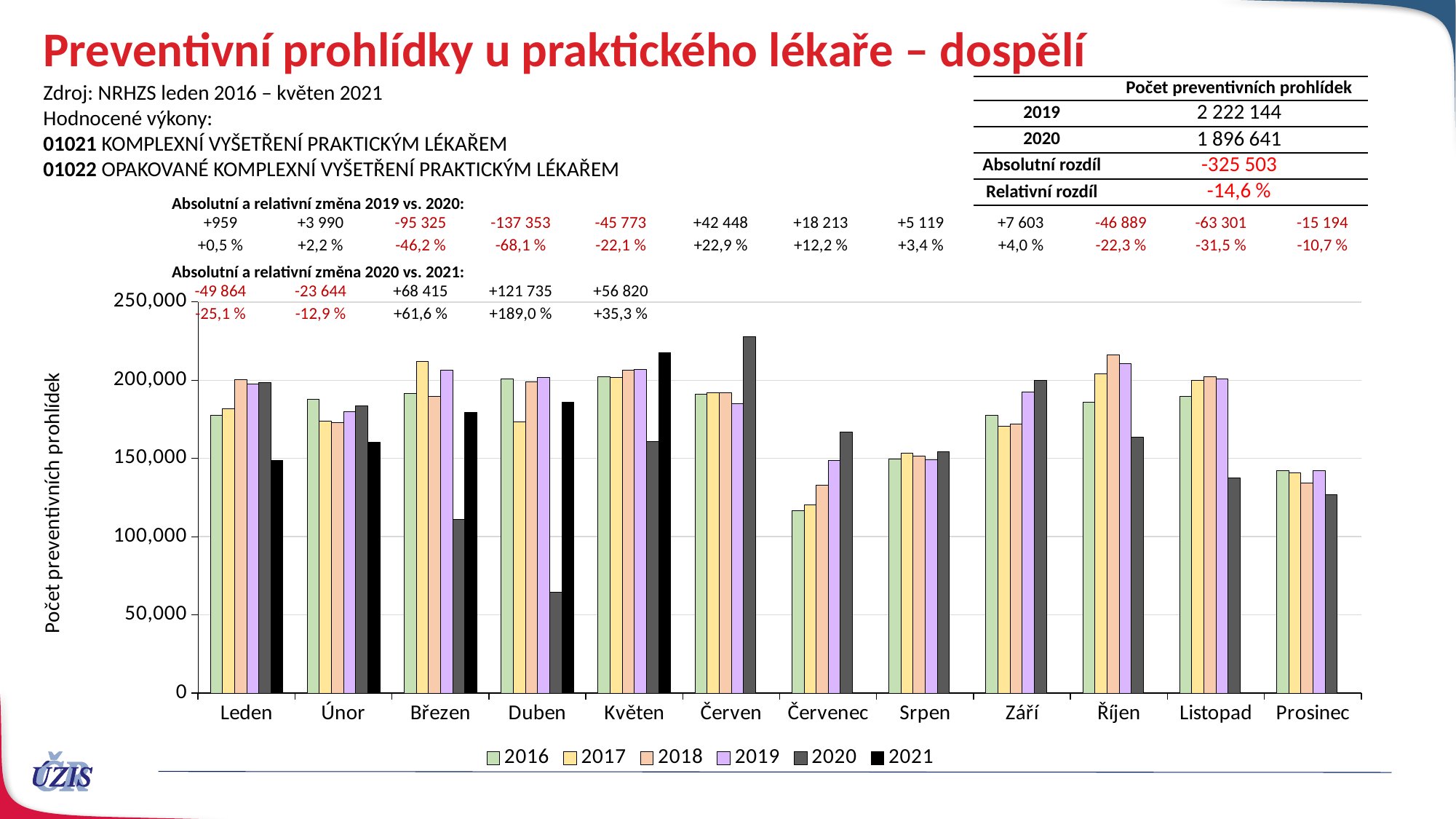
How many months (categories) are shown on the x axis of the chart? 12 In Březen, which is larger: the value for 2019 or the value for 2020? 2019 Is the value for 2020 in Březen greater or less than 150,000? less How many series does the chart legend list? 6 Is the value for 2020 in Červen greater or less than 200,000? greater Is the value for 2020 in Duben greater or less than 100,000? less In Duben, which is larger: the value for 2020 or the value for 2021? 2021 For the 2020 series, which month has the lowest value? Duben What kind of chart is shown on the slide? bar chart For the 2020 series, which month has the highest value? Červen